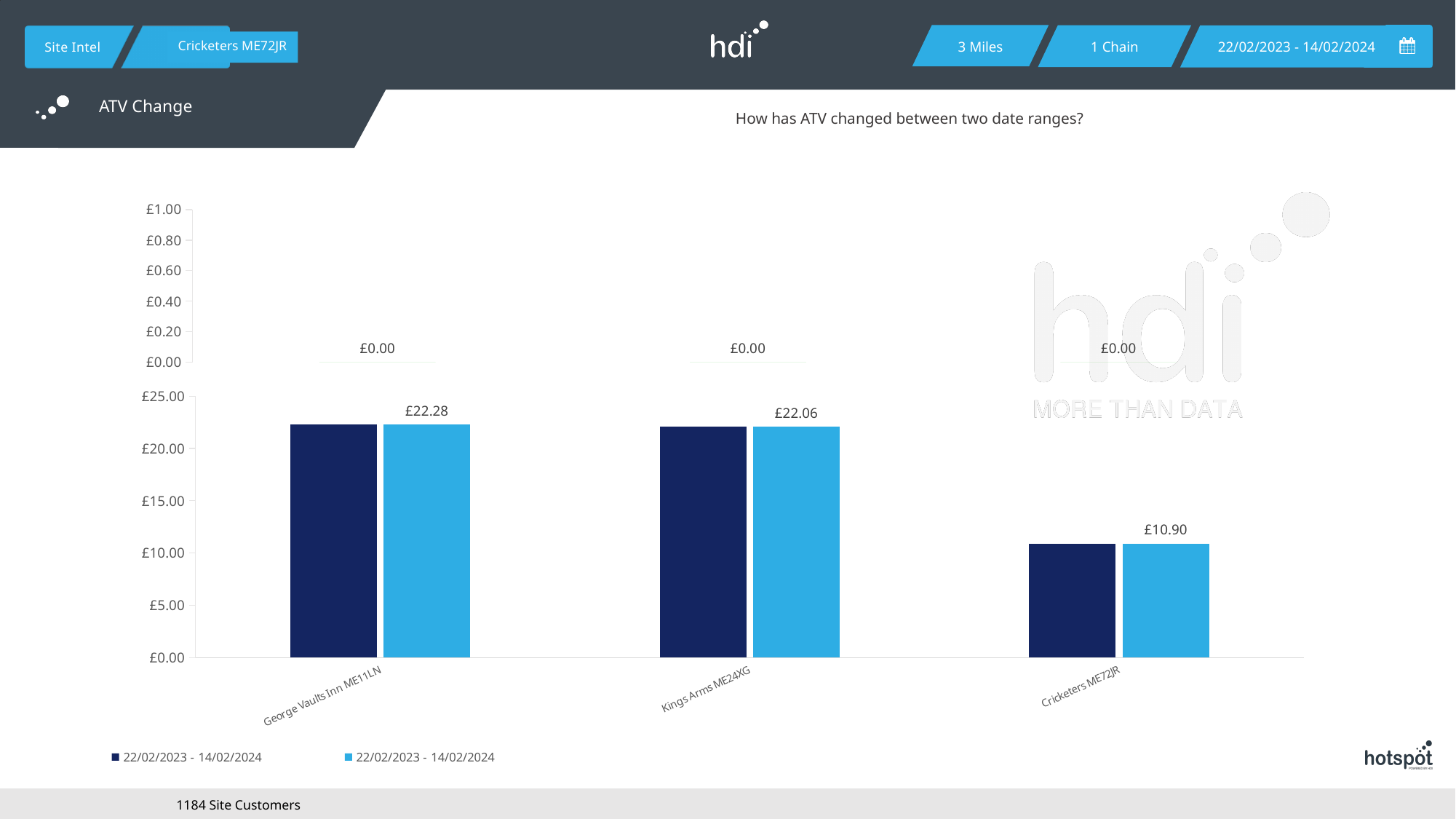
What change value is labelled for each site in the upper chart? £0.00 What ATV value is labelled for Cricketers ME72JR in the lower chart? £10.90 What ATV value is labelled for George Vaults Inn ME11LN in the lower chart? £22.28 How many series does the legend list? 2 How many sites are shown on the x axis of the chart? 3 Is the labelled ATV for Cricketers ME72JR greater or less than £15.00? less Which site has the highest labelled ATV in the lower chart? George Vaults Inn ME11LN What kind of chart is shown on the slide? bar chart Which site has the lowest labelled ATV in the lower chart? Cricketers ME72JR What ATV value is labelled for Kings Arms ME24XG in the lower chart? £22.06 Which is larger, the labelled ATV for Kings Arms ME24XG or for Cricketers ME72JR? Kings Arms ME24XG What is the difference between the labelled ATV for George Vaults Inn ME11LN and Cricketers ME72JR? £11.38